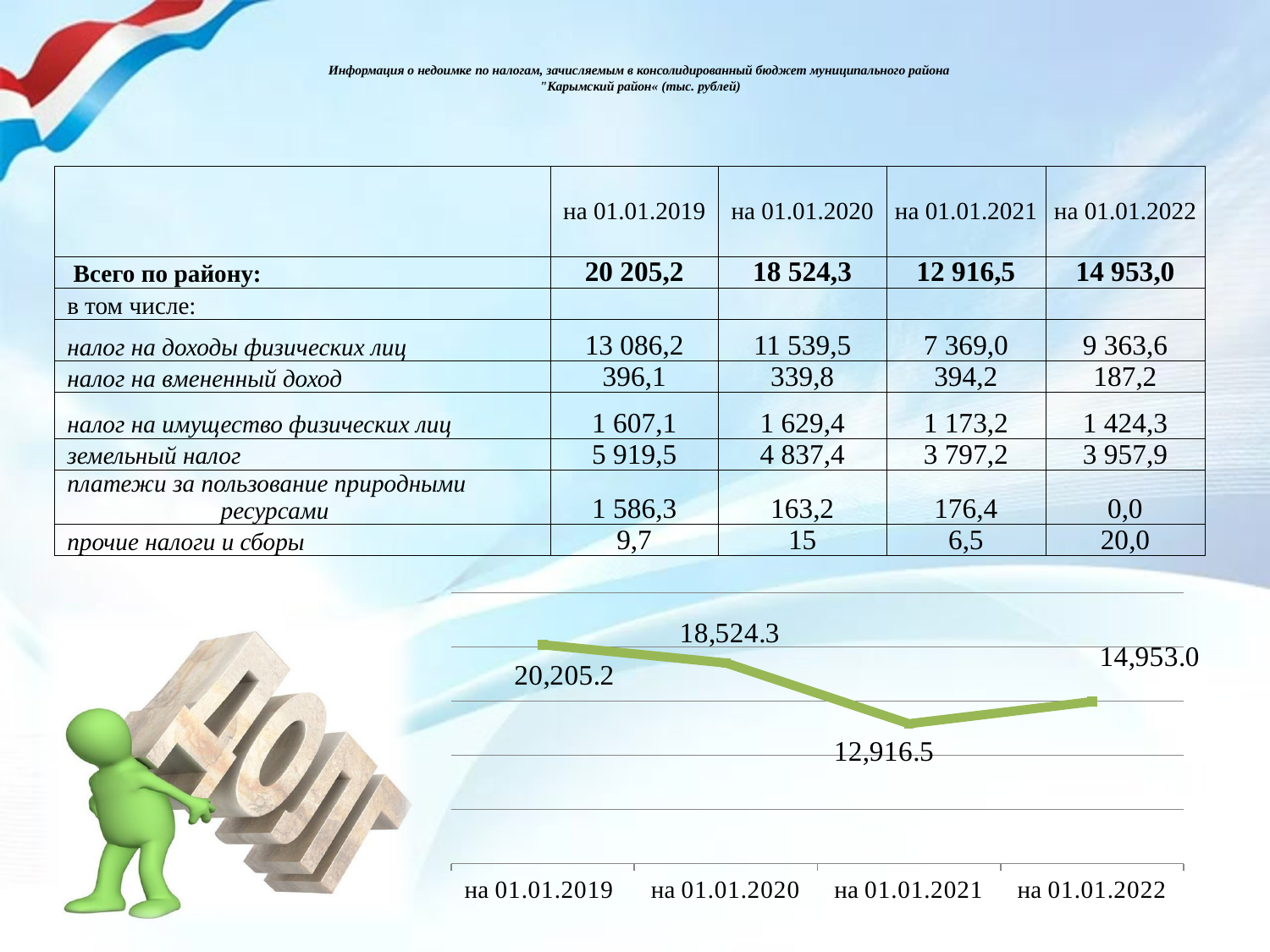
What type of chart is shown at the bottom of the slide? line chart In the line chart, which is larger: the value for на 01.01.2020 or the value for на 01.01.2022? на 01.01.2020 In the line chart, what is the value for на 01.01.2021? 12,916.5 In the line chart, does the value rise or fall from на 01.01.2019 to на 01.01.2021? fall How many data points are plotted in the line chart? 4 In the line chart, what is the value for на 01.01.2019? 20,205.2 In the line chart, what is the value for на 01.01.2022? 14,953.0 In the line chart, what is the difference between the values for на 01.01.2019 and на 01.01.2020? 1,680.9 In the line chart, what is the difference between the values for на 01.01.2022 and на 01.01.2021? 2,036.5 In the line chart, which date has the lowest value? на 01.01.2021 In the line chart, which date has the highest value? на 01.01.2019 In the line chart, what is the value for на 01.01.2020? 18,524.3